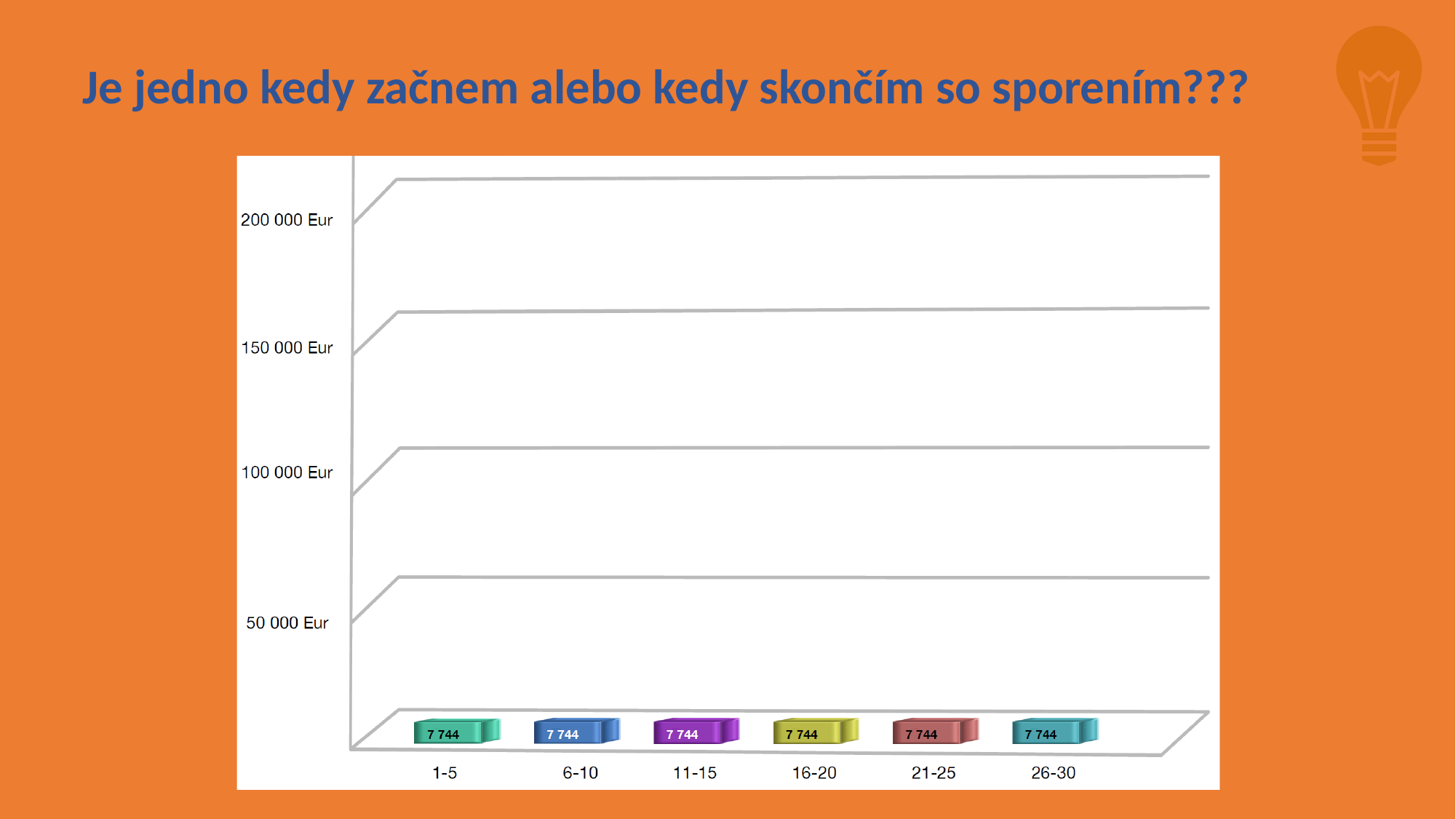
How many categories are shown on the x axis? 6 What is the value for the 1-5 category? 7 744 What is the difference between the values for 6-10 and 21-25? 0 Is the value for 11-15 greater or less than 50 000 Eur? less What is the value for the 16-20 category? 7 744 What is the highest tick label shown on the vertical axis? 200 000 Eur What kind of chart is shown on the slide? bar chart Do the values rise, fall or stay the same from 1-5 to 26-30? stay the same What is the value for the 26-30 category? 7 744 Is the value for 26-30 greater or less than 100 000 Eur? less What is the label of the first category on the x axis? 1-5